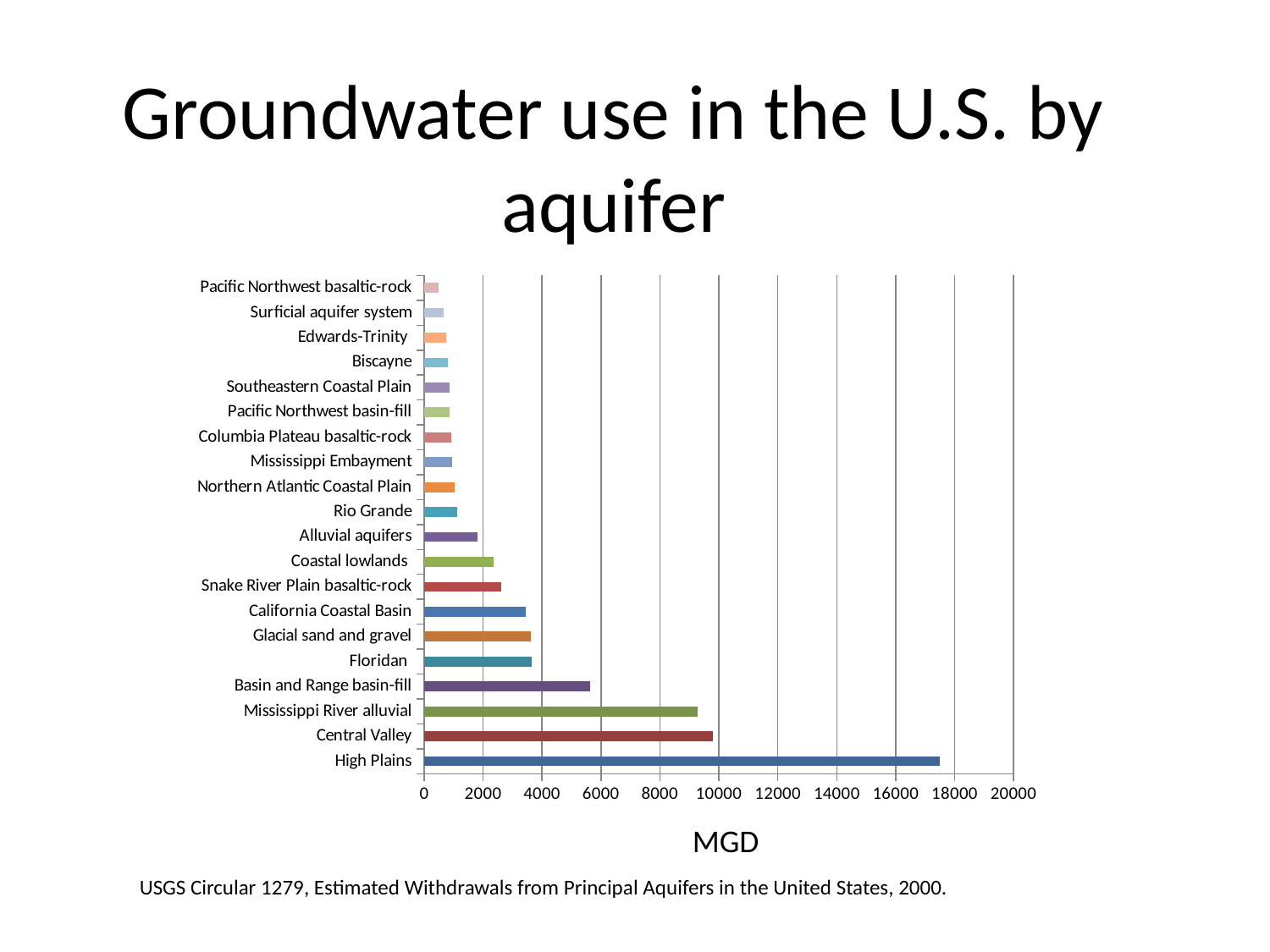
Which aquifer has the highest groundwater use? High Plains What is the label on the horizontal axis of the chart? MGD What kind of chart is shown on the slide? bar chart Is the value for Rio Grande greater or less than 2000? less Which has a larger value, Snake River Plain basaltic-rock or Alluvial aquifers? Snake River Plain basaltic-rock Is the value for Central Valley greater or less than 10000? less How many aquifers are plotted in the chart? 20 Is the value for Basin and Range basin-fill greater or less than 4000? greater Which aquifer has the lowest groundwater use? Pacific Northwest basaltic-rock Which has a larger value, Basin and Range basin-fill or Floridan? Basin and Range basin-fill